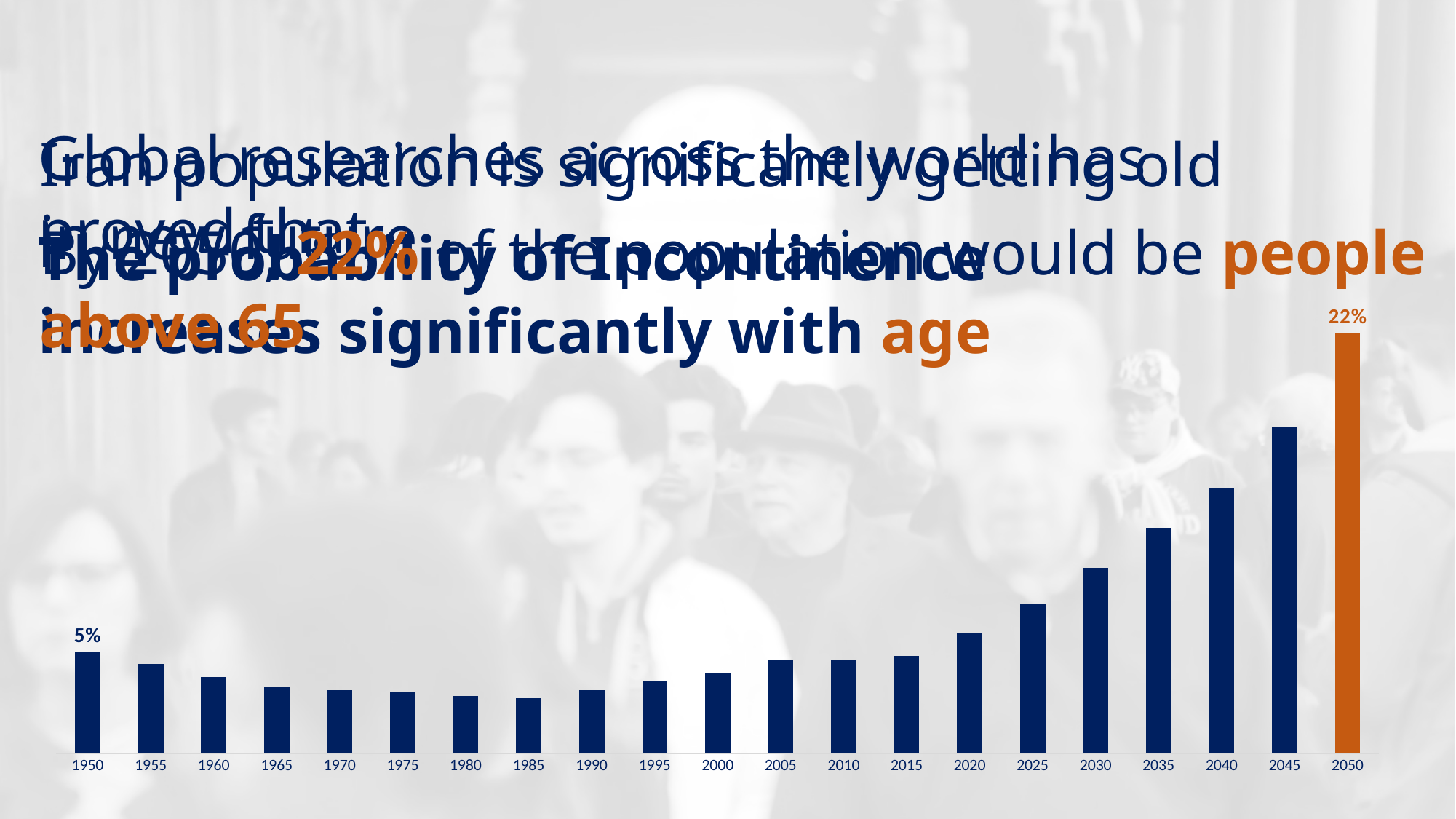
Which is larger, the value for 2030 or the value for 2020? 2030 Which year has the highest bar? 2050 Do the values rise or fall from 2000 to 2050? Rise What kind of chart is shown on the slide? Bar chart What is the difference between the values for 2050 and 1950? 17% What is the value shown for 2050? 22% What is the value shown for 1950? 5% Which is larger, the value for 1950 or the value for 1990? 1950 Do the values rise or fall from 1950 to 1985? Fall Which is larger, the value for 2045 or the value for 2040? 2045 How many years are shown on the x axis? 21 Which bar is coloured orange instead of dark blue? 2050